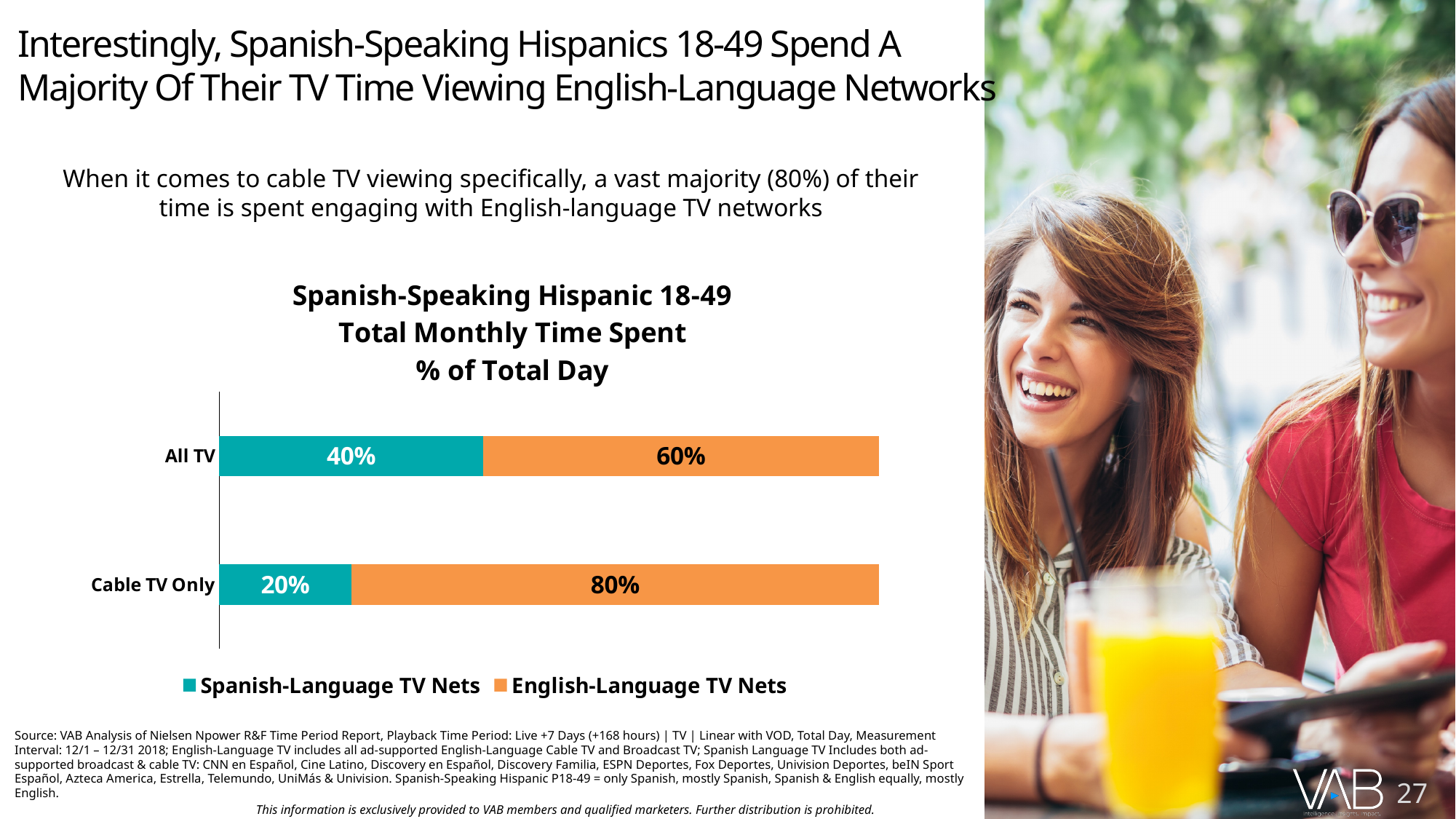
What is the total of the Cable TV Only stacked bar? 100% What is the difference between the English-Language TV Nets values for Cable TV Only and All TV? 20% Which category has the lowest value for Spanish-Language TV Nets? Cable TV Only How many series does the legend list? 2 Which category has the higher value for English-Language TV Nets, All TV or Cable TV Only? Cable TV Only What is the value for English-Language TV Nets in the All TV bar? 60% What kind of chart is shown on the slide? Stacked bar chart What is the difference between the English-Language and Spanish-Language TV Nets values in the All TV bar? 20% What is the value for Spanish-Language TV Nets in the Cable TV Only bar? 20% What is the value for English-Language TV Nets in the Cable TV Only bar? 80% What is the value for Spanish-Language TV Nets in the All TV bar? 40% How many categories are shown on the chart? 2